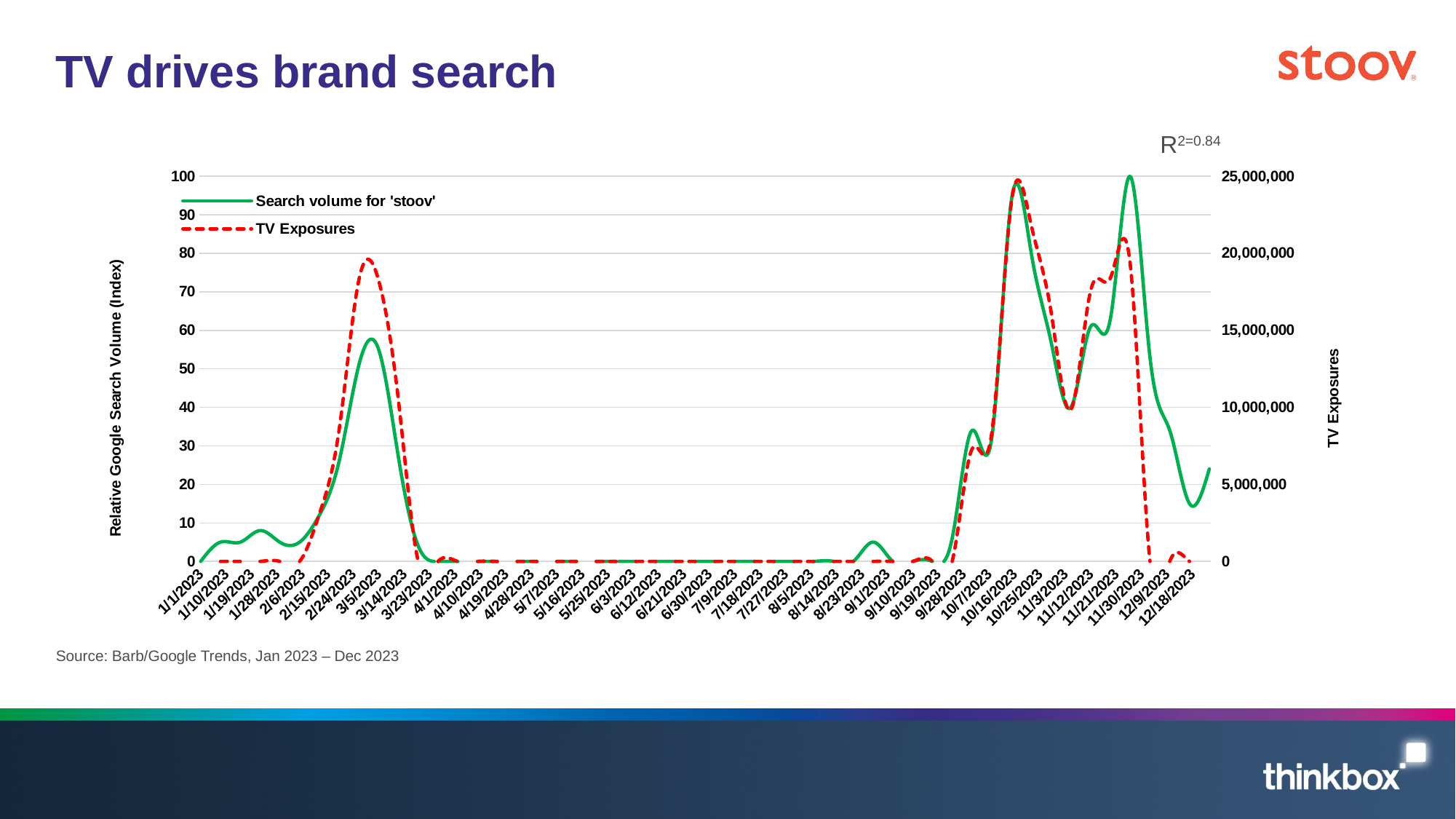
Is the search volume for 'stoov' at 12/18/2023 greater or less than 30? less What kind of chart is shown on the slide? Line chart Does the TV Exposures line rise or fall between 11/30/2023 and 12/9/2023? fall Is the search volume for 'stoov' around 3/5/2023 greater or less than 50? greater What is the highest value shown on the right-hand (TV Exposures) axis? 25,000,000 Is the value of TV Exposures around 3/5/2023 greater or less than 15,000,000? greater Does the search volume for 'stoov' rise or fall between 9/19/2023 and 10/16/2023? rise How many date labels are shown along the x axis of the chart? 40 Which series is drawn as a red dashed line? TV Exposures What is the title of the slide containing the chart? TV drives brand search How many series does the chart's legend list? 2